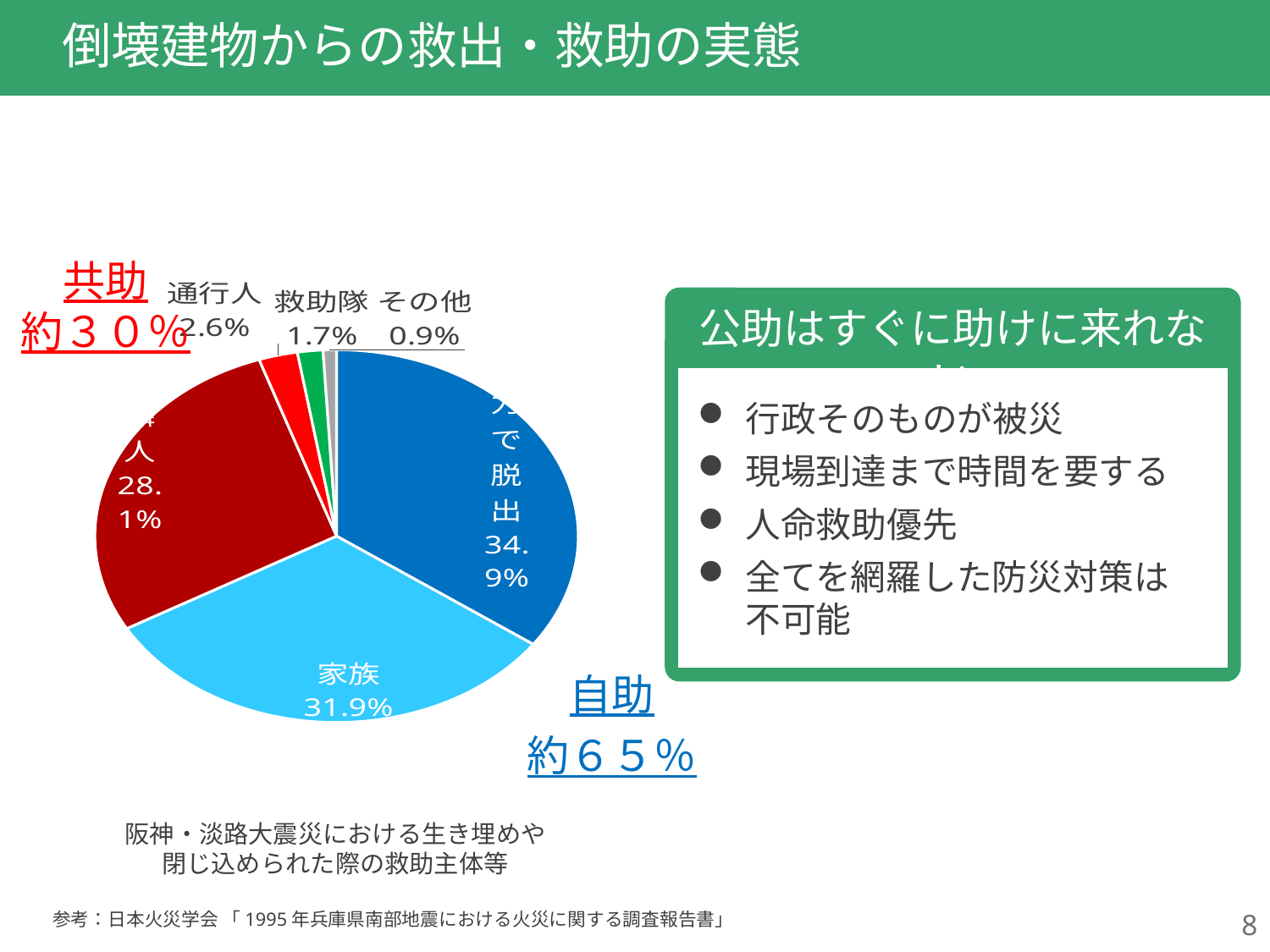
What is the caption written below the pie chart? 阪神・淡路大震災における生き埋めや閉じ込められた際の救助主体等 What is the difference in percentage points between the 家族 slice and the 通行人 slice? 29.3 What colour is the 家族 slice in the pie chart? light blue What is the percentage of the largest slice in the pie chart? 34.9% Which labelled slice of the pie chart has the smallest share? その他 What kind of chart is shown on the slide? pie chart What percentage does the 救助隊 slice represent in the pie chart? 1.7% What percentage does the 家族 slice represent in the pie chart? 31.9% What percentage does the その他 slice represent in the pie chart? 0.9% Which slice is larger, 救助隊 or その他? 救助隊 How many slices does the pie chart have? 6 What percentage does the 通行人 slice represent in the pie chart? 2.6%